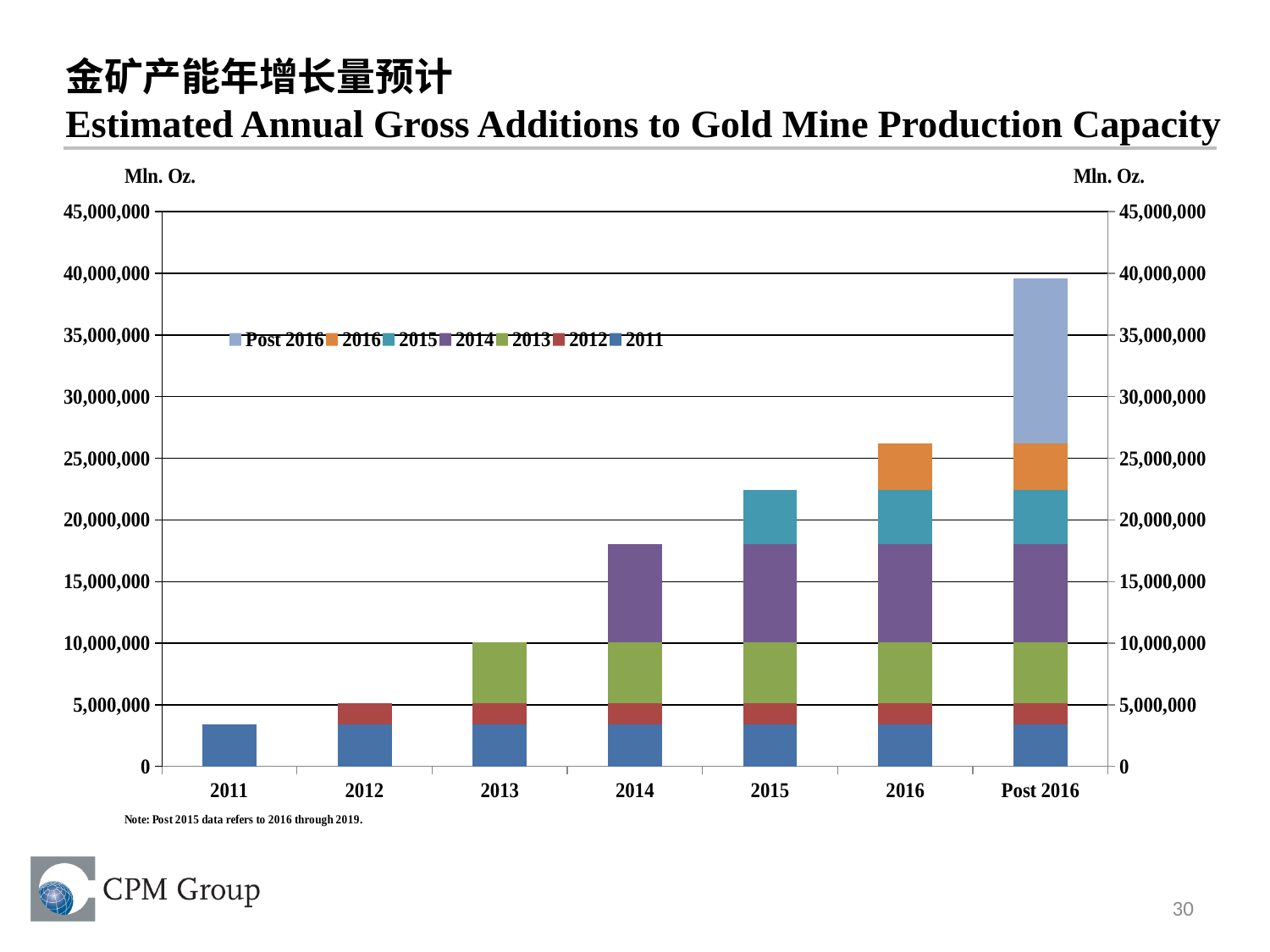
Is the total value for 2014 greater or less than 15,000,000? greater Do the stacked bar totals rise or fall from 2011 to Post 2016? rise How many series does the legend list? 7 Which category has the shortest stacked bar? 2011 Which has the larger total stacked bar, 2015 or 2014? 2015 How many categories are shown along the x axis? 7 Is the total value for 2011 greater or less than 5,000,000? less What kind of chart is shown on the slide? Stacked bar chart Which category has the tallest stacked bar? Post 2016 What unit is shown on the y axis of the chart? Mln. Oz. Is the total value for 2015 greater or less than 20,000,000? greater